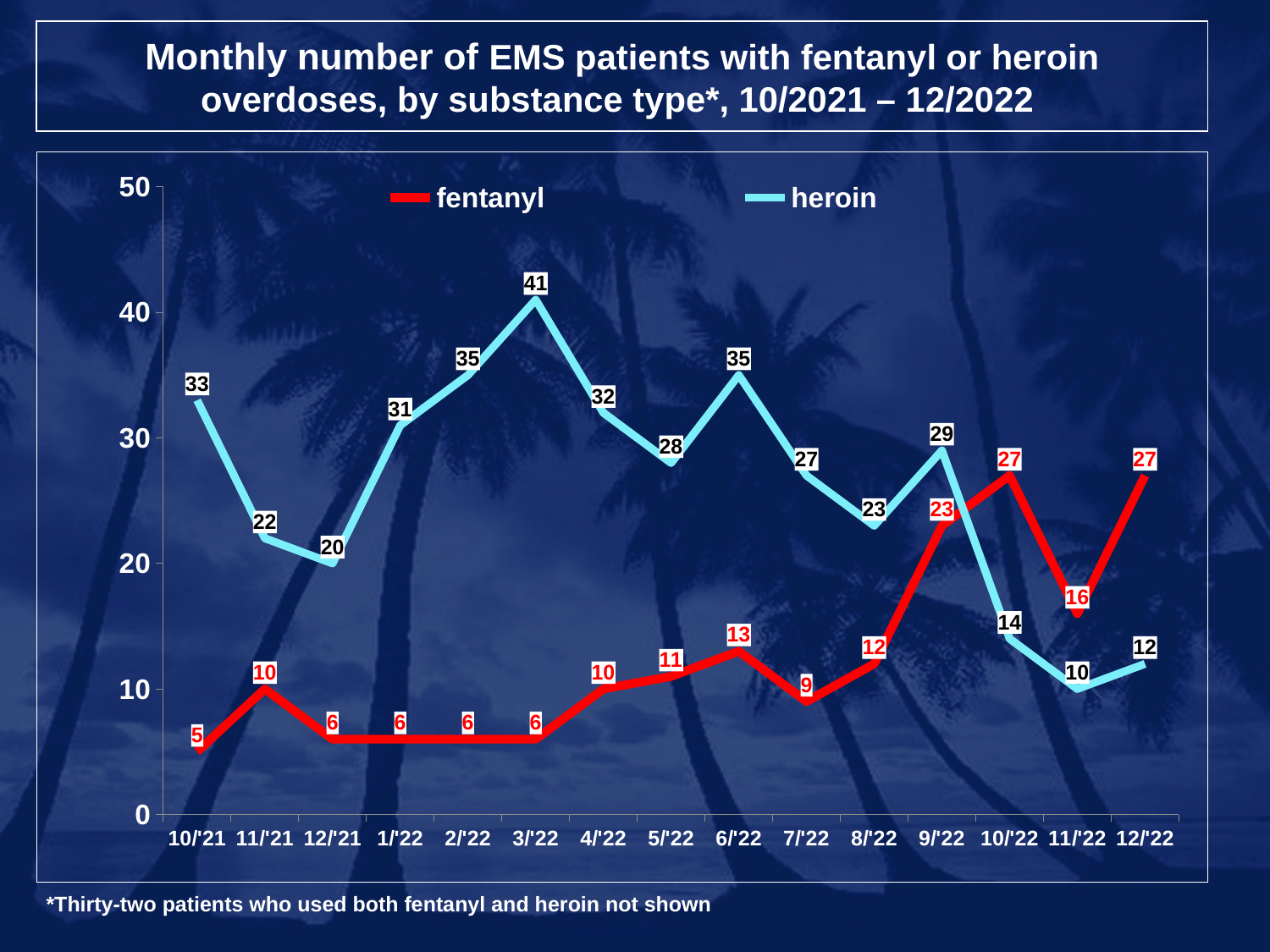
In which month is the heroin series at its lowest value? 11/'22 Which series has the larger value in 6/'22, fentanyl or heroin? heroin What is the number of heroin overdose patients in 3/'22? 41 What is the difference between the heroin and fentanyl values in 3/'22? 35 In which month is the fentanyl series at its lowest value? 10/'21 How many months are shown on the x axis? 15 What is the number of fentanyl overdose patients in 9/'22? 23 How many series does the legend list? 2 In which month does the heroin series reach its highest value? 3/'22 What is the heroin value for 10/'21? 33 What kind of chart is shown on the slide? line chart Which series has the larger value in 10/'22, fentanyl or heroin? fentanyl